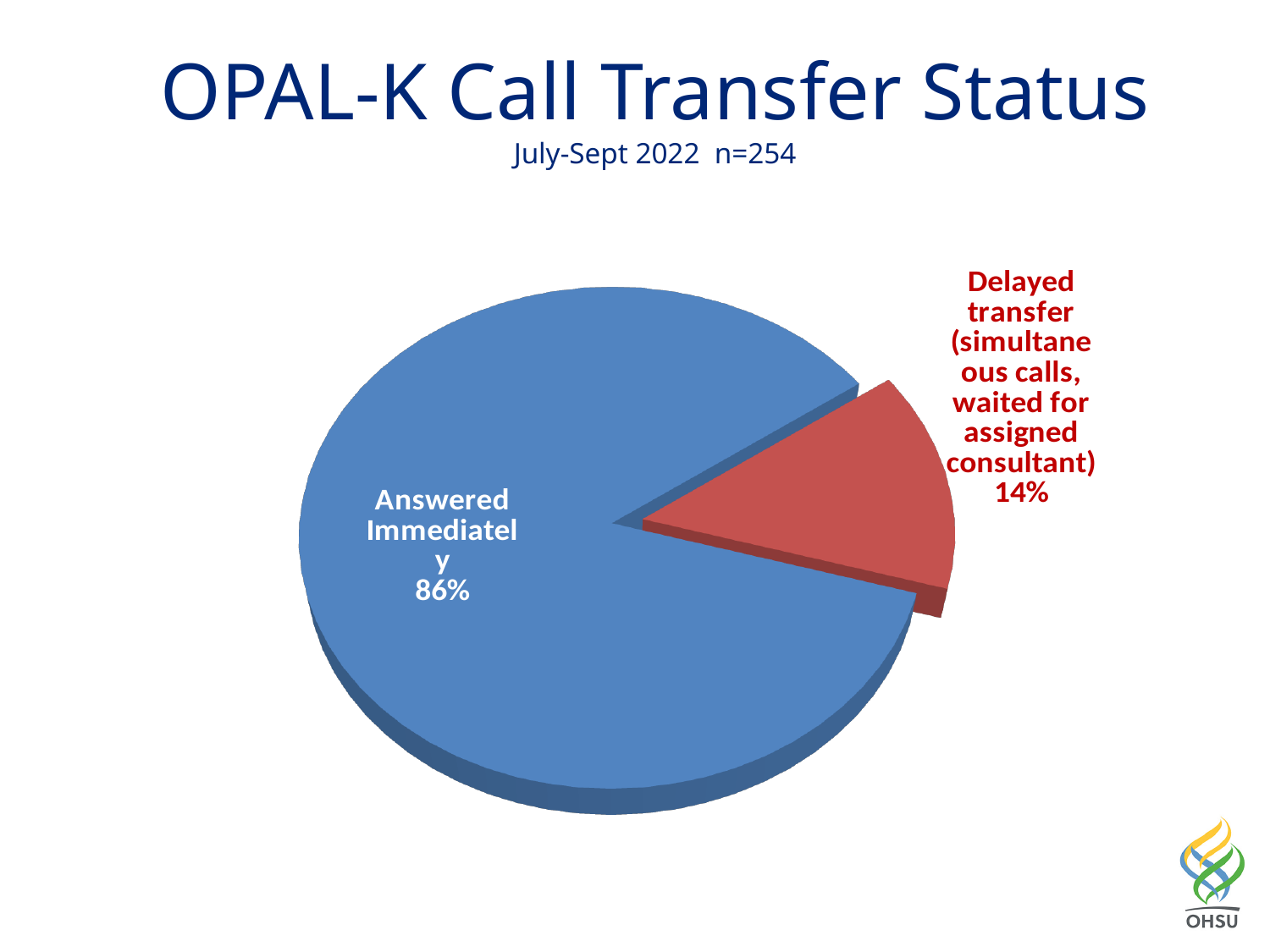
What is the difference in percentage points between Answered Immediately and Delayed transfer? 72 How many slices does the pie chart have? 2 What share of calls were Answered Immediately? 86% What kind of chart is shown on the slide? pie chart What is the total of the two slice percentages shown? 100% What is the sample size (n) shown in the subtitle? 254 Which category has the smallest share of the pie? Delayed transfer What is the title of the chart on the slide? OPAL-K Call Transfer Status Which is larger, the share for Answered Immediately or the share for Delayed transfer? Answered Immediately Which category has the largest share of the pie? Answered Immediately What share of calls had a Delayed transfer? 14%